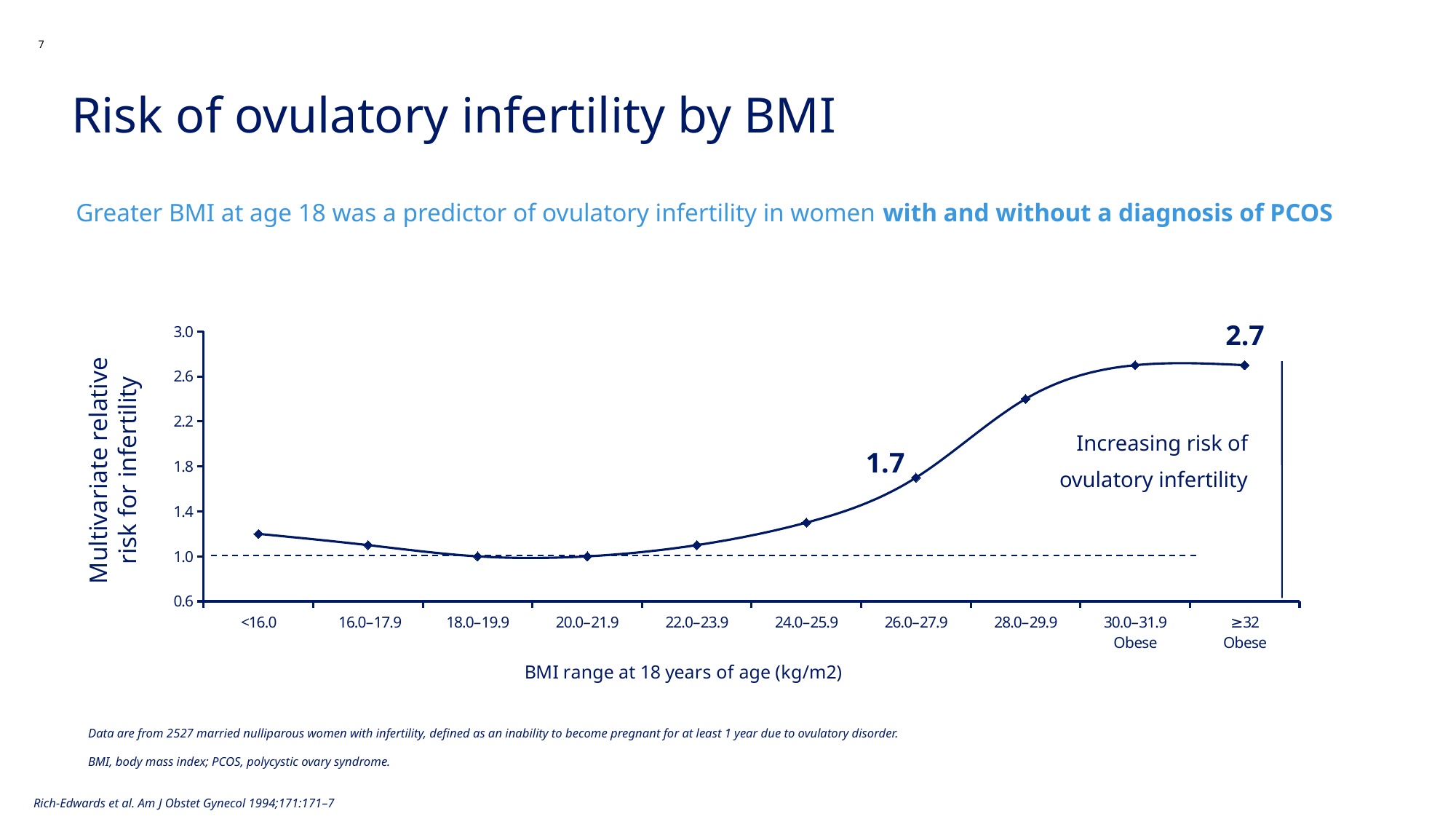
Is the relative risk for the BMI range 22.0–23.9 greater or less than 1.4? less Is the relative risk for the BMI range 28.0–29.9 greater or less than 2.2? greater What is the multivariate relative risk for infertility for the BMI range 20.0–21.9? 1.0 What is the difference in relative risk between the ≥32 BMI range and the 26.0–27.9 BMI range? 1.0 What kind of chart is shown on the slide? Line chart Does the relative risk for infertility rise or fall as BMI increases from 20.0–21.9 to 30.0–31.9? Rise What is the multivariate relative risk for infertility for the BMI range 26.0–27.9? 1.7 Which BMI range has the larger relative risk for infertility: 26.0–27.9 or ≥32? ≥32 What is the title of the x axis of the chart? BMI range at 18 years of age (kg/m2) How many BMI ranges are plotted on the x axis? 10 What is the multivariate relative risk for infertility for the BMI range ≥32 (Obese)? 2.7 Is the relative risk for the BMI range <16.0 greater or less than 1.0? greater